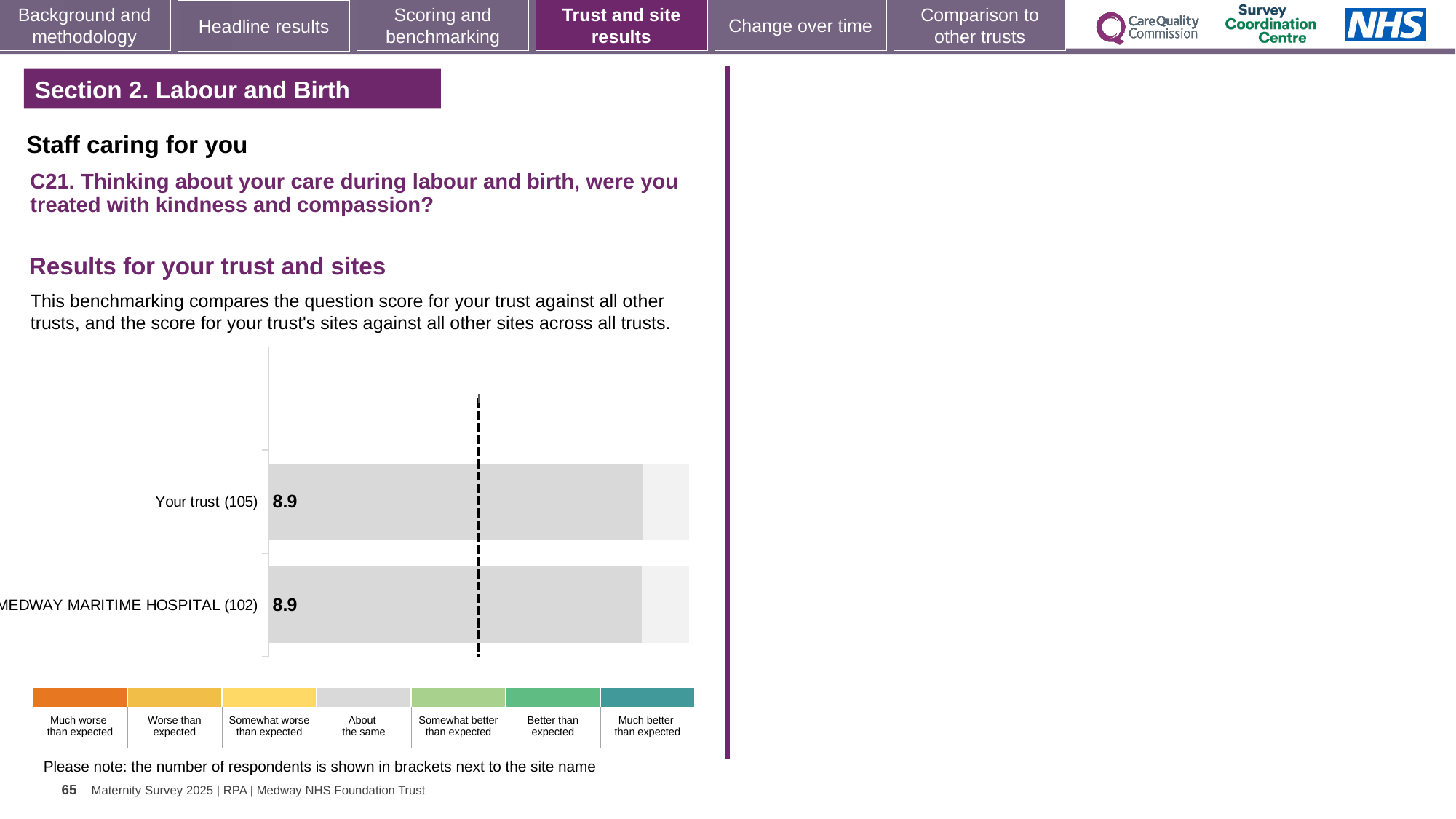
Which category in the colour key is shown in orange? Much worse than expected Which benchmark category does the grey colour of the bars correspond to in the key? About the same How many respondents are shown in brackets for MEDWAY MARITIME HOSPITAL? 102 Is the score for Your trust higher than, lower than, or equal to the score for MEDWAY MARITIME HOSPITAL? Equal How many benchmark categories does the colour key below the chart list? 7 What is the score for MEDWAY MARITIME HOSPITAL? 8.9 What is the score for Your trust? 8.9 What kind of chart is shown on the slide? Bar chart How many respondents are shown in brackets for Your trust? 105 What is the difference between the score for Your trust and the score for MEDWAY MARITIME HOSPITAL? 0 How many bars are plotted in the chart? 2